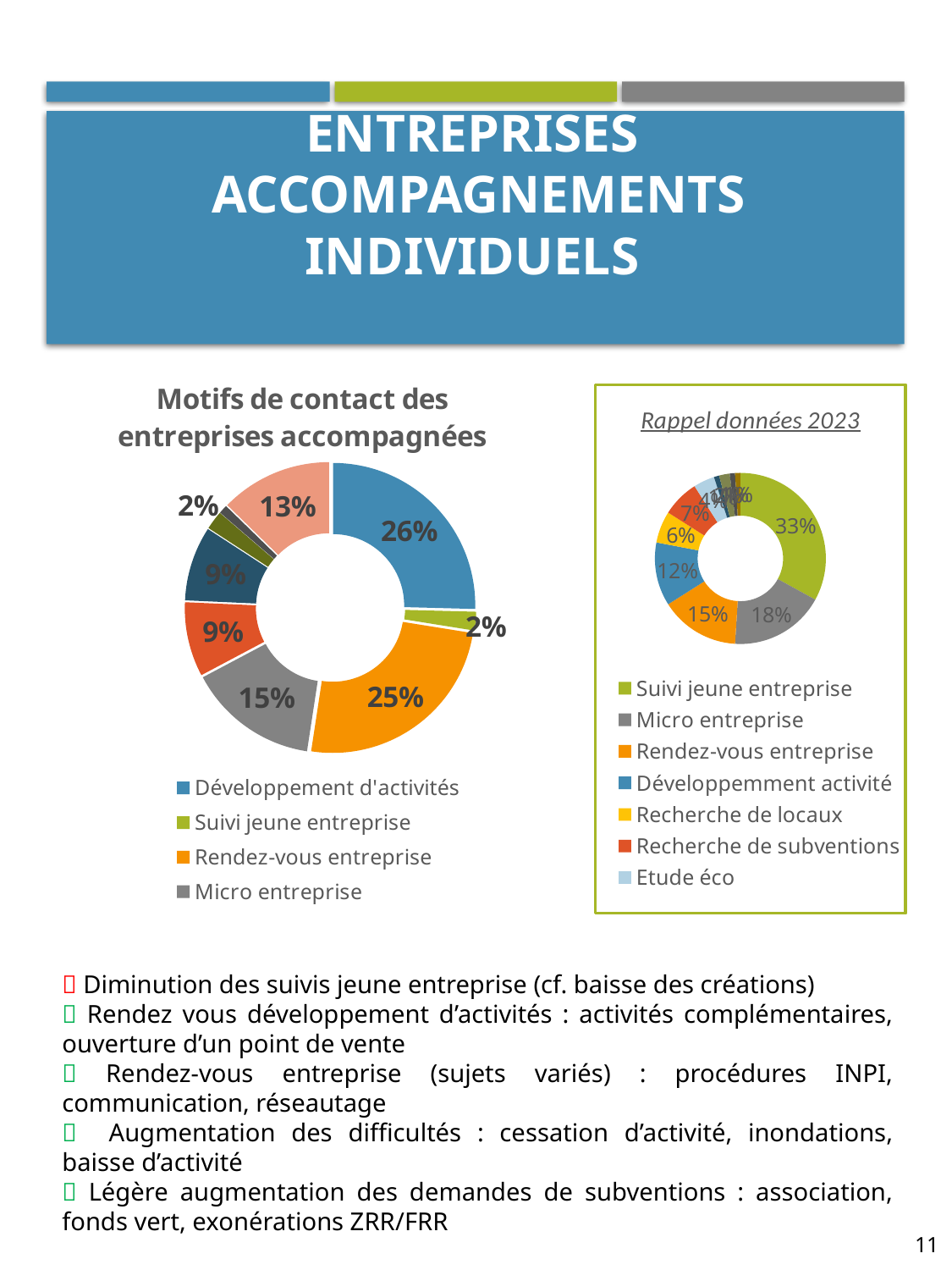
In the chart titled 'Motifs de contact des entreprises accompagnées', which is larger: Micro entreprise or Rendez-vous entreprise? Rendez-vous entreprise In the chart titled 'Motifs de contact des entreprises accompagnées', what percentage is shown for Suivi jeune entreprise? 2% In the 'Rappel données 2023' chart, what percentage is shown for Micro entreprise? 18% In the 'Rappel données 2023' chart, what percentage is shown for Suivi jeune entreprise? 33% What kind of chart is the 'Motifs de contact des entreprises accompagnées' chart? Doughnut (pie) chart In the chart titled 'Motifs de contact des entreprises accompagnées', what percentage is shown for Micro entreprise? 15% In the chart titled 'Motifs de contact des entreprises accompagnées', what percentage is shown for Développement d'activités? 26% In the 'Rappel données 2023' chart, what is the difference in percentage points between Suivi jeune entreprise and Micro entreprise? 15 percentage points In the 'Rappel données 2023' chart, which category has the largest share? Suivi jeune entreprise In the 'Rappel données 2023' chart, how many entries does the legend list? 7 In the chart titled 'Motifs de contact des entreprises accompagnées', how many entries does the legend list? 4 In the chart titled 'Motifs de contact des entreprises accompagnées', what percentage is shown for Rendez-vous entreprise? 25%